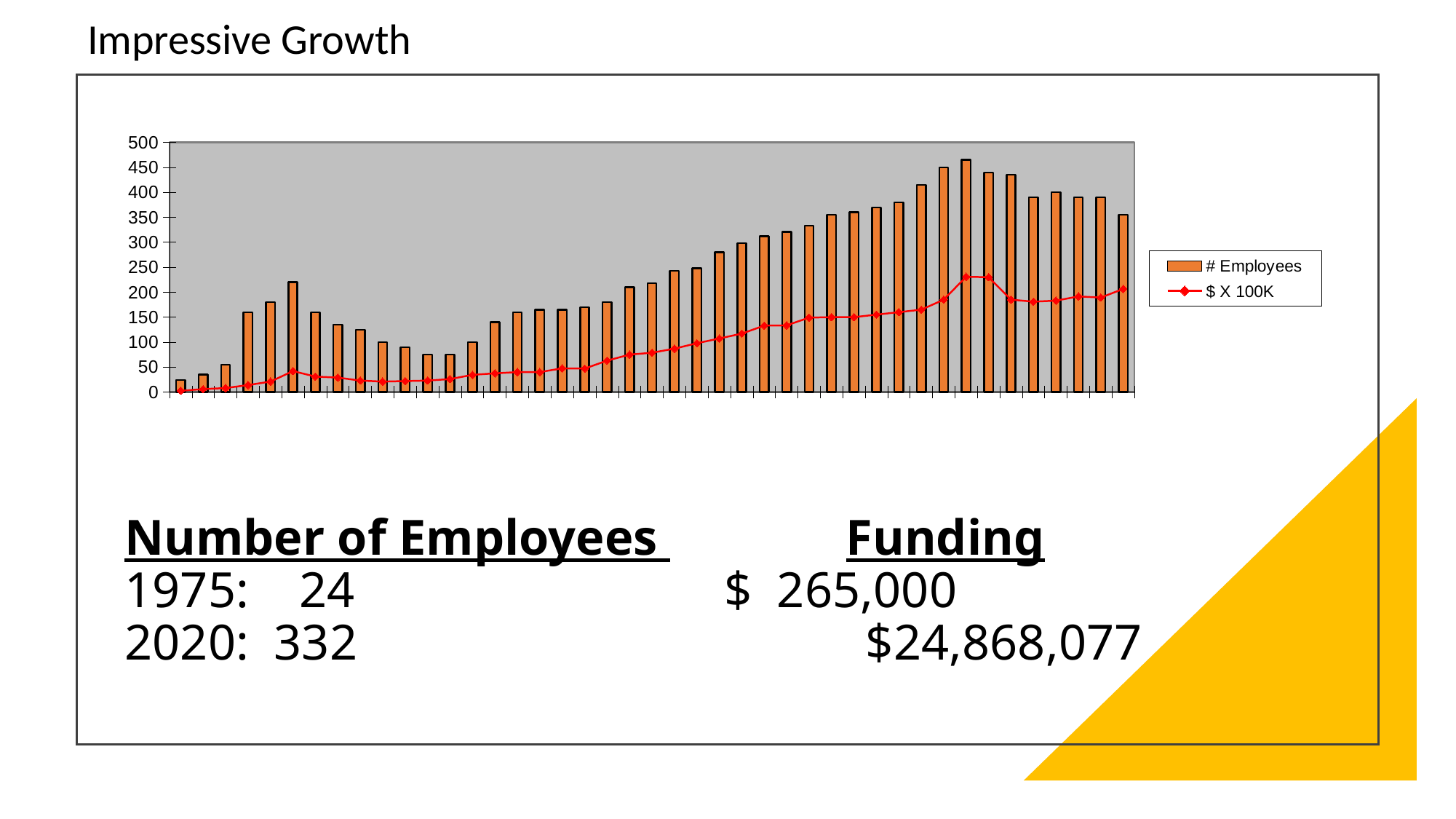
How many series does the chart legend list? 2 Is the highest point of the $ X 100K line greater or less than 250? less Overall, does the $ X 100K line rise or fall from left to right across the chart? rise Is the first # Employees bar on the left greater or less than 50? less What are the two series named in the chart legend? # Employees and $ X 100K Which series in the chart is drawn as a red line with diamond markers? $ X 100K What kind of chart is shown on the slide? A combined bar and line chart Is the tallest # Employees bar greater or less than 400? greater What is the highest value shown on the chart's vertical axis? 500